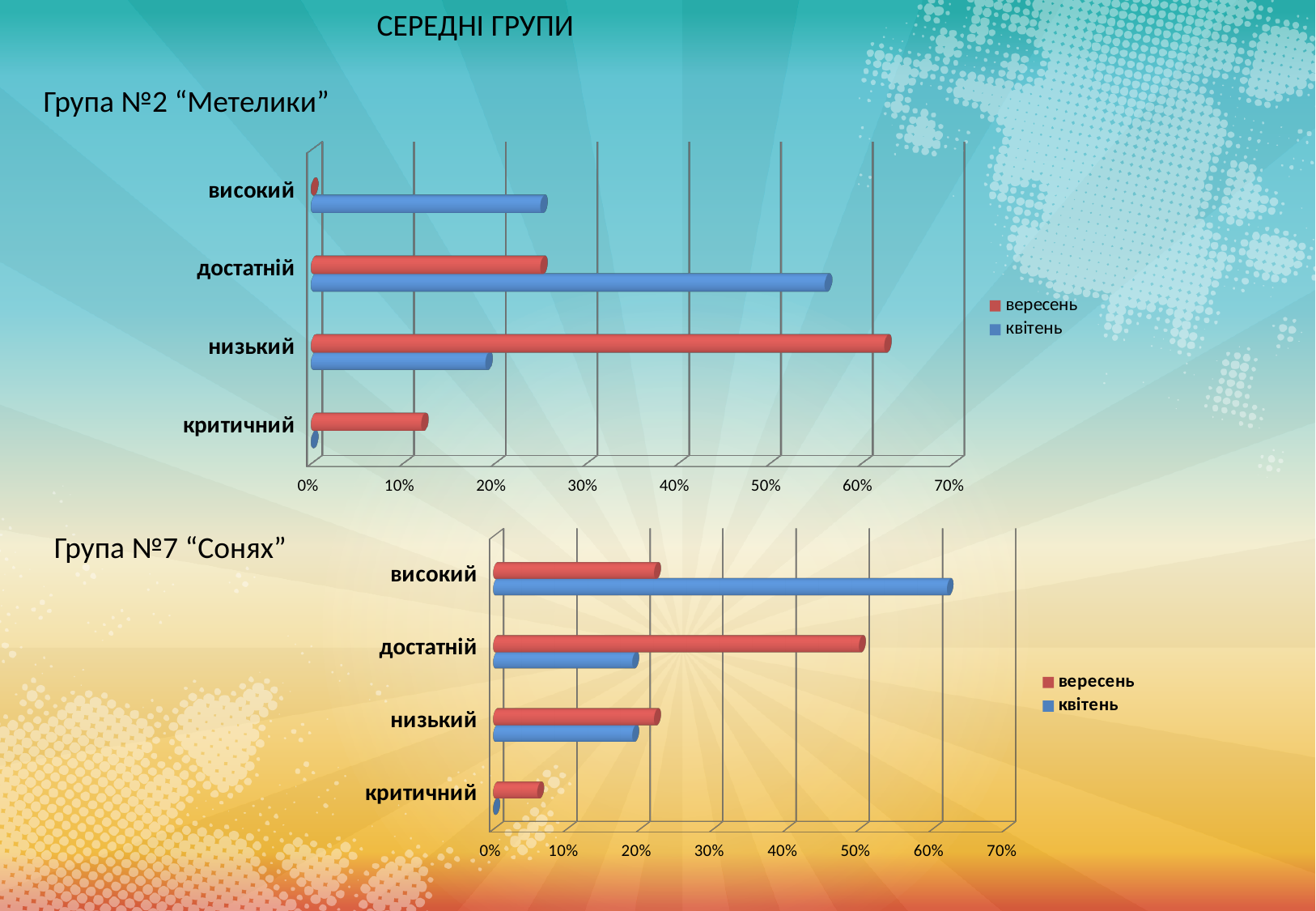
In the chart for Група №7 “Сонях”, which is larger for достатній: вересень or квітень? вересень In the chart for Група №2 “Метелики”, is the value for низький in вересень greater or less than 60%? greater In the chart for Група №7 “Сонях”, which category has the highest value for квітень? високий In the chart for Група №7 “Сонях”, which category has the highest value for вересень? достатній In the chart for Група №2 “Метелики”, which category has the highest value for квітень? достатній In the chart for Група №7 “Сонях”, is the value for високий in квітень greater or less than 60%? greater How many categories are shown in the chart for Група №7 “Сонях”? 4 In the chart for Група №2 “Метелики”, which is larger for критичний: вересень or квітень? вересень In the chart for Група №7 “Сонях”, is the value for критичний in вересень greater or less than 10%? less What type of chart is used for Група №2 “Метелики”? bar chart